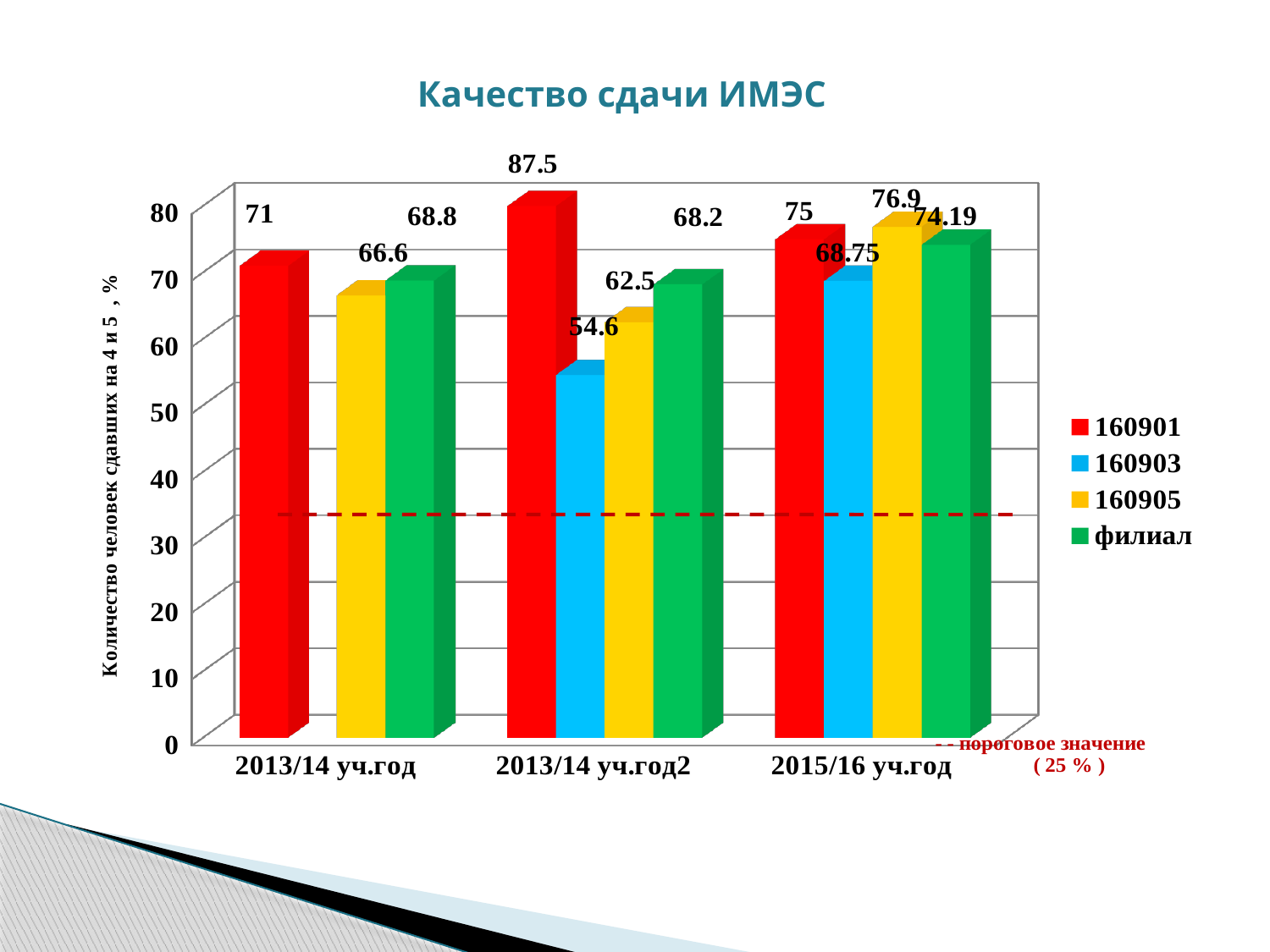
What is the title of the chart? Качество сдачи ИМЭС How many categories are shown on the x axis? 3 How many series does the legend list? 4 What is the value for 160903 in 2015/16 уч.год? 68.75 Which series has the highest value in 2013/14 уч.год2? 160901 What is the difference between the 160901 value and the 160903 value in 2013/14 уч.год2? 32.9 Which series has the lowest value in 2013/14 уч.год2? 160903 What is the value for 160901 in 2013/14 уч.год2? 87.5 What is the value for филиал in 2013/14 уч.год? 68.8 Which is larger in 2015/16 уч.год: the value for 160905 or the value for филиал? 160905 What type of chart is shown on the slide? bar chart What is the value for 160905 in 2013/14 уч.год2? 62.5